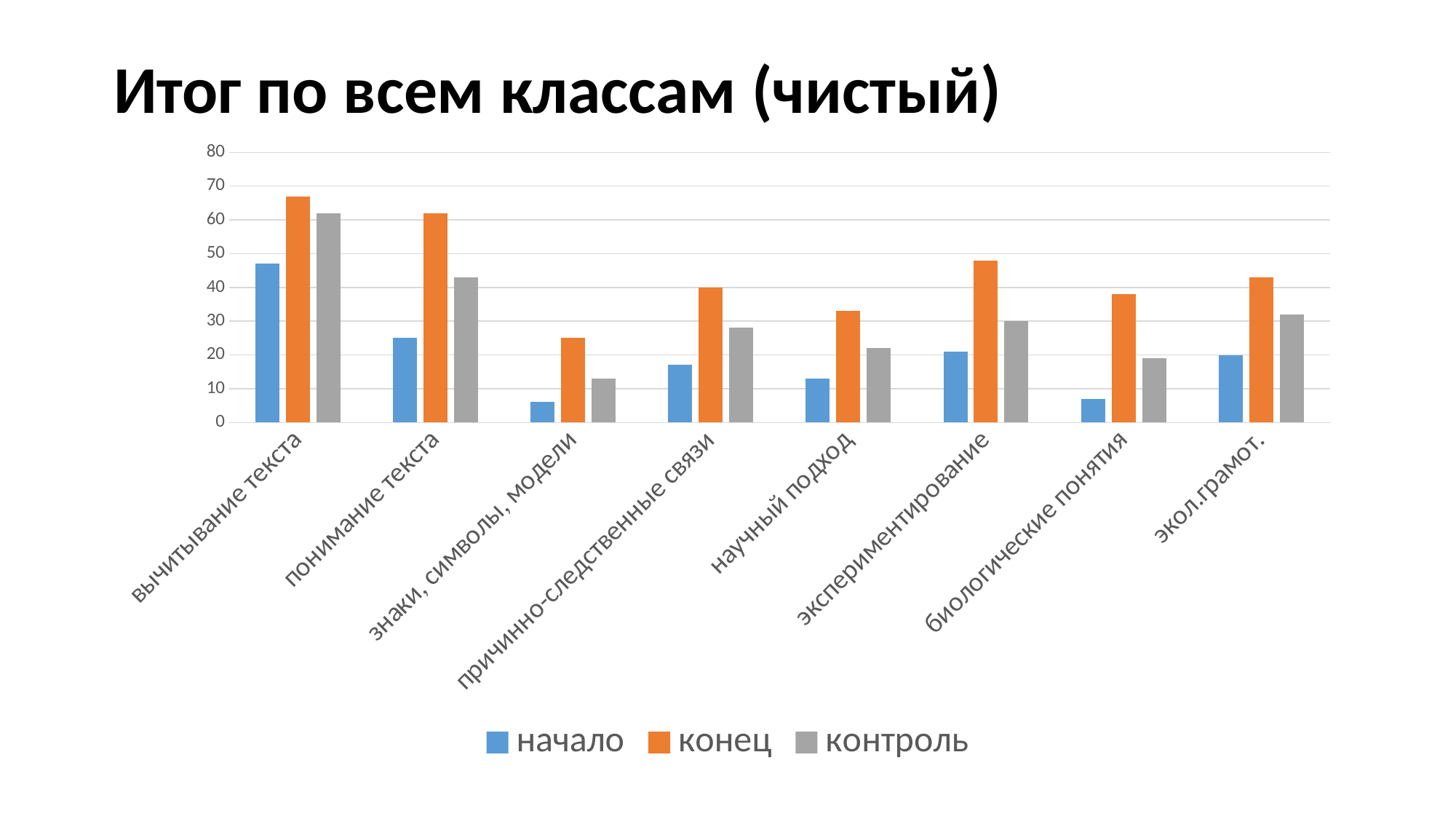
How many categories are shown along the x axis of the chart? 8 How many series does the legend list? 3 Which category has the larger 'начало' value: 'экспериментирование' or 'биологические понятия'? экспериментирование Is the value of 'конец' for 'экспериментирование' greater or less than 40? greater Is the value of 'начало' for 'вычитывание текста' greater or less than 40? greater What kind of chart is shown on the slide? bar chart Which category has the lowest value for the series 'начало'? знаки, символы, модели Is the value of 'конец' for 'знаки, символы, модели' greater or less than 30? less What are the three series listed in the legend? начало, конец, контроль For 'понимание текста', which series has the larger value: 'конец' or 'контроль'? конец What is the title of the slide? Итог по всем классам (чистый) Which category has the highest value for the series 'конец'? вычитывание текста